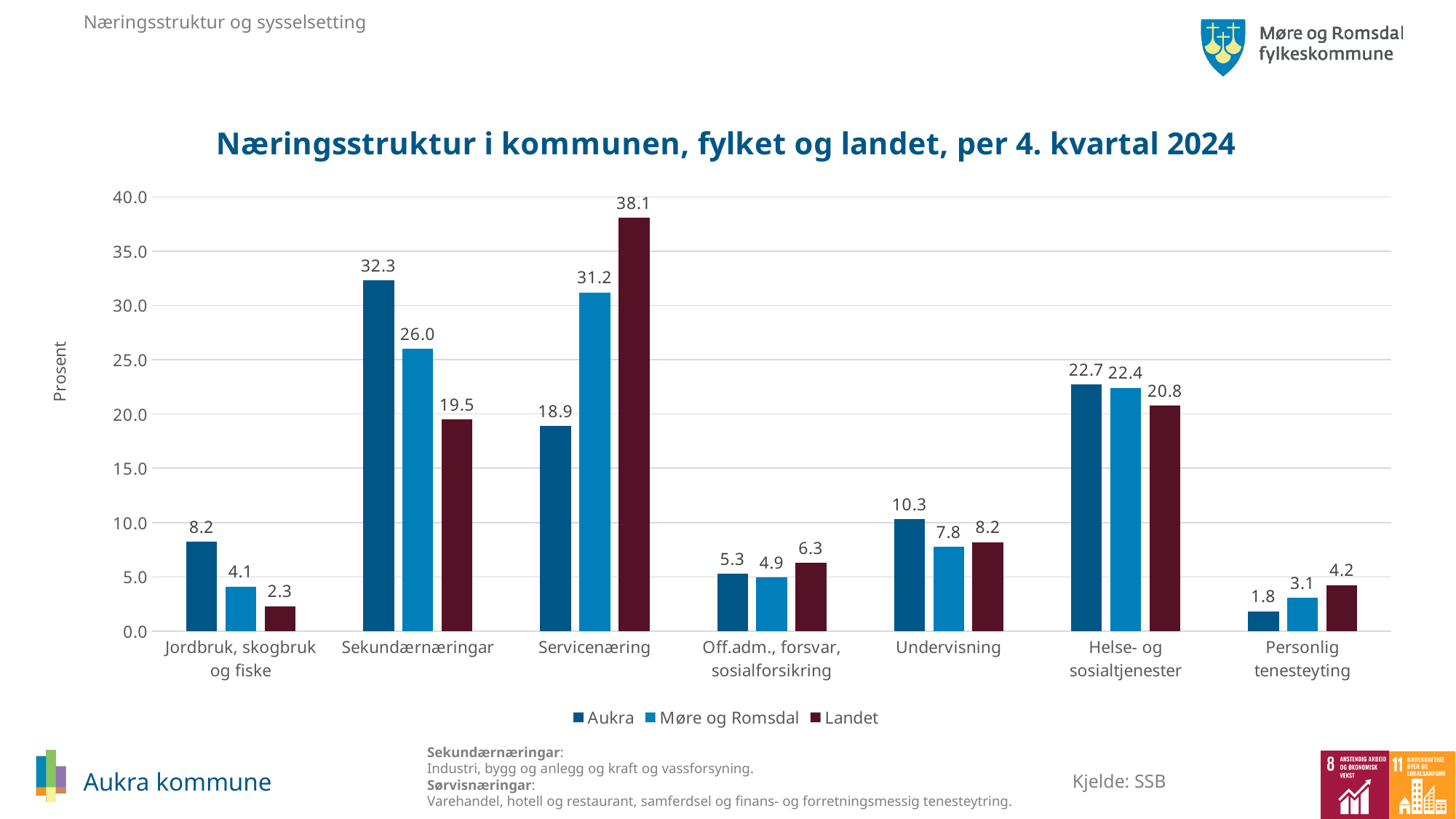
What is the difference between the Aukra and Landet values in the Jordbruk, skogbruk og fiske category? 5.9 What is the value for Aukra in the Sekundærnæringar category? 32.3 Which category has the highest value for Aukra? Sekundærnæringar What kind of chart is shown on the slide? bar chart Is the value for Landet in the Sekundærnæringar category greater or less than 20.0? less How many categories are shown on the x axis? 7 How many series does the legend list? 3 What is the value for Møre og Romsdal in the Undervisning category? 7.8 Which is larger in the Servicenæring category: the value for Aukra or the value for Møre og Romsdal? Møre og Romsdal What is the value for Landet in the Servicenæring category? 38.1 What is the title of the chart? Næringsstruktur i kommunen, fylket og landet, per 4. kvartal 2024 Which category has the lowest value for Landet? Jordbruk, skogbruk og fiske